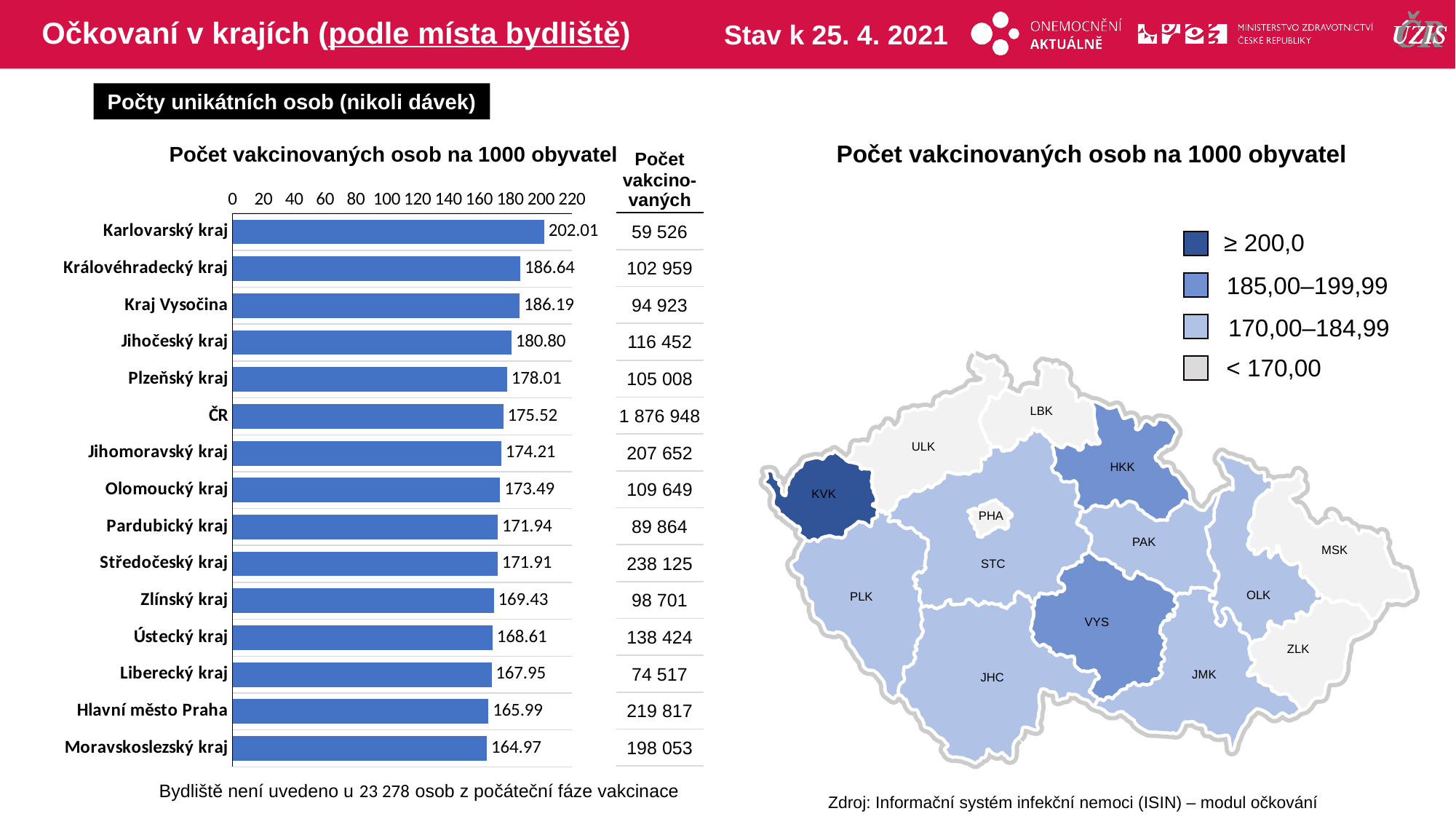
In the bar chart, is the value for Zlínský kraj greater or less than 180? less What is the title of the bar chart on the left of the slide? Počet vakcinovaných osob na 1000 obyvatel In the bar chart, do the values rise or fall going from the top bar to the bottom bar? fall In the bar chart, what is the difference between the values for Karlovarský kraj and Moravskoslezský kraj? 37.04 In the bar chart, what is the value for ČR? 175.52 In the bar chart 'Počet vakcinovaných osob na 1000 obyvatel', what is the value for Karlovarský kraj? 202.01 In the bar chart, which category has the lowest value? Moravskoslezský kraj In the bar chart, which category has the highest value? Karlovarský kraj What kind of chart is shown on the left of the slide? bar chart In the bar chart, which is larger: the value for Jihočeský kraj or the value for Plzeňský kraj? Jihočeský kraj In the bar chart, what is the value for Hlavní město Praha? 165.99 How many categories (bars) does the bar chart show? 15